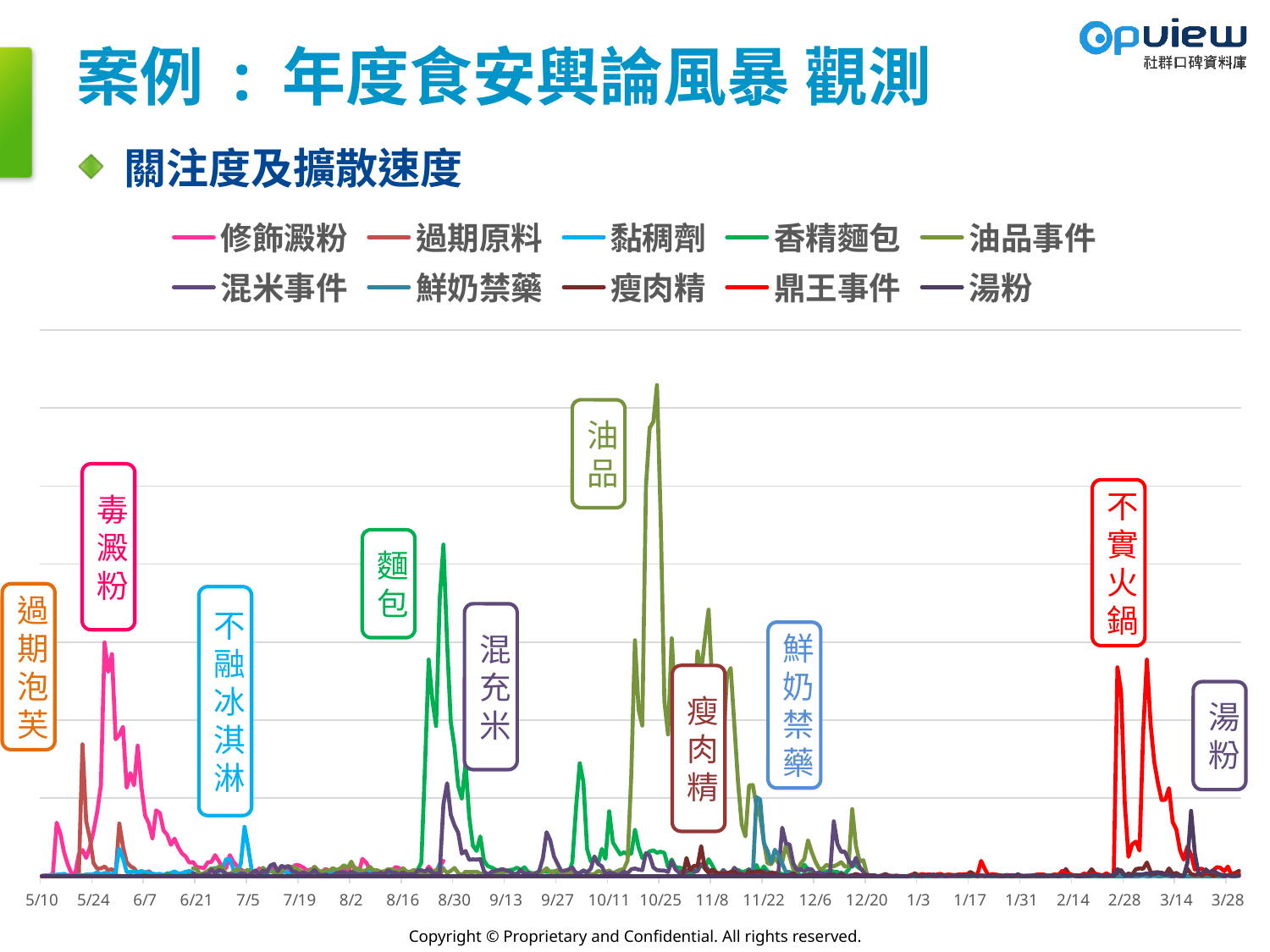
How many date labels are shown on the x axis? 24 What is the heading shown above the chart legend? 關注度及擴散速度 What is the first date label on the x axis? 5/10 What kind of chart is shown on the slide? line chart Near which x-axis date does the 油品事件 series reach its highest peak? 10/25 What colour is the 鼎王事件 series line? red Which series shows its peaks between 2/28 and 3/14? 鼎王事件 What is the last date label on the x axis? 3/28 Which series has the higher peak, 油品事件 or 香精麵包? 油品事件 Which series reaches the highest peak on the chart? 油品事件 Which series has the higher peak, 香精麵包 or 修飾澱粉? 香精麵包 How many series does the chart legend list? 10